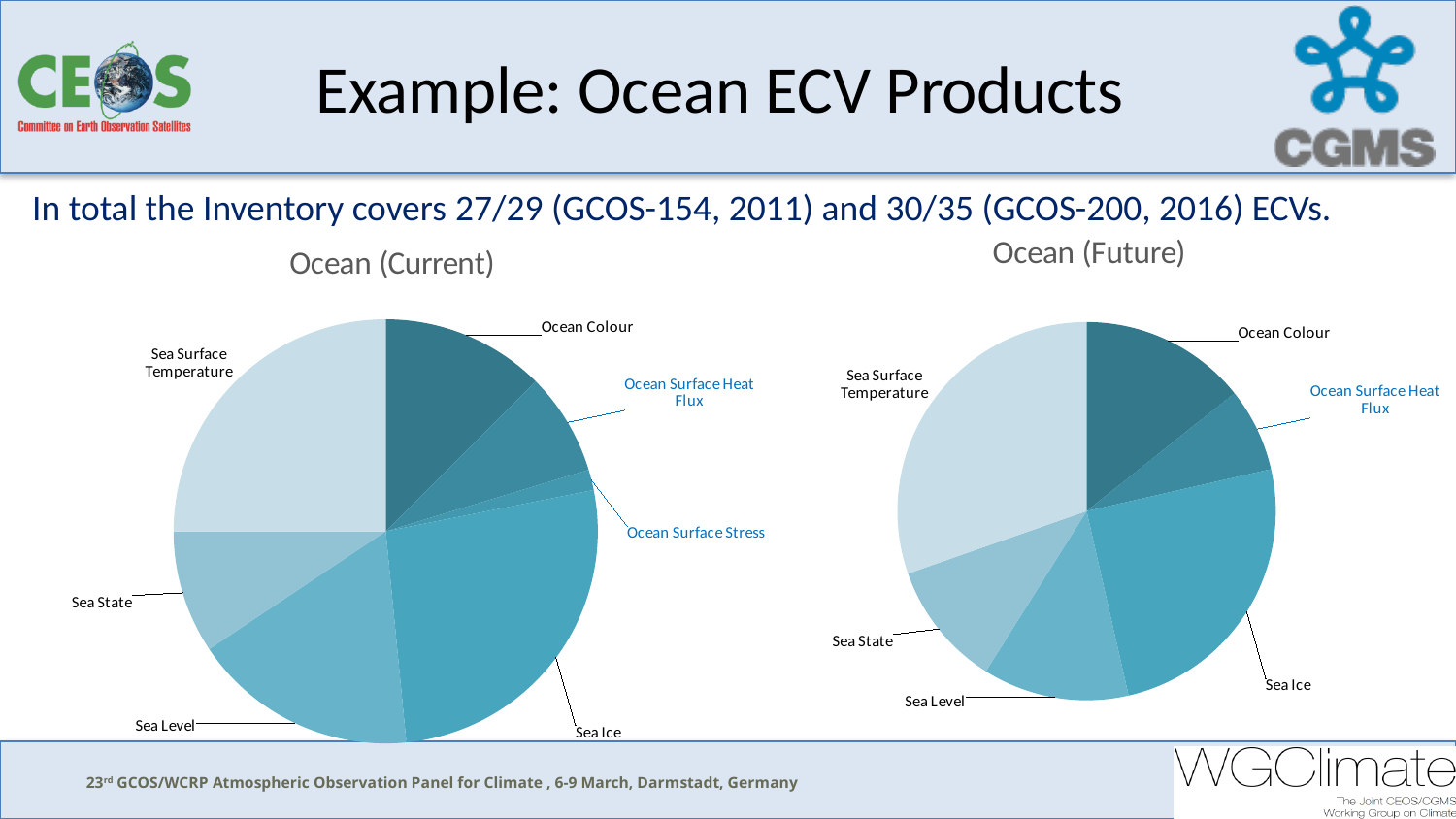
In the Ocean (Current) pie chart, which category has the smallest slice? Ocean Surface Stress In the Ocean (Current) pie chart, which slice is larger, Ocean Colour or Ocean Surface Stress? Ocean Colour How many categories are labelled on the Ocean (Current) pie chart? 7 Which category is labelled on the Ocean (Current) pie chart but not on the Ocean (Future) pie chart? Ocean Surface Stress What kind of chart is the Ocean (Future) chart? pie chart How many categories are labelled on the Ocean (Future) pie chart? 6 In the Ocean (Future) pie chart, which category has the largest slice? Sea Surface Temperature In the Ocean (Future) pie chart, which slice is larger, Sea Surface Temperature or Sea State? Sea Surface Temperature In the Ocean (Current) pie chart, which slice is larger, Sea Ice or Ocean Surface Stress? Sea Ice What is the title of the pie chart on the left of the slide? Ocean (Current) What kind of chart is the Ocean (Current) chart? pie chart